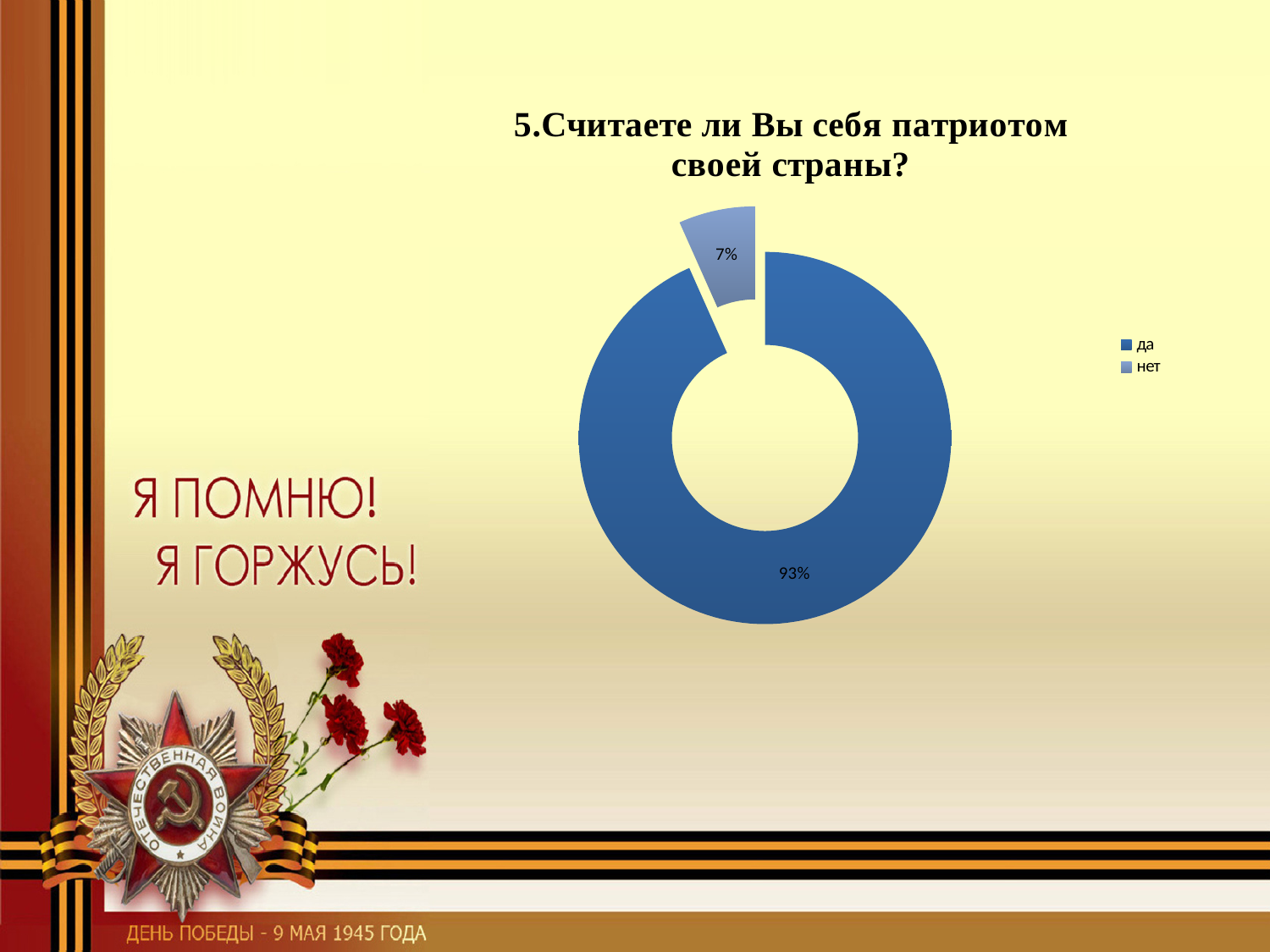
What kind of chart is shown on the slide? Doughnut (pie) chart Which answer has the largest share of the chart? да What is the title of the chart? 5.Считаете ли Вы себя патриотом своей страны? How many entries does the legend list? 2 Which answer has the smallest share of the chart? нет Which is larger, the share for "да" or the share for "нет"? да What percentage of respondents answered "да"? 93% What percentage of respondents answered "нет"? 7% How many categories does the chart show? 2 Which legend entry is shown in the lighter blue colour? нет What is the difference in percentage points between the "да" and "нет" shares? 86